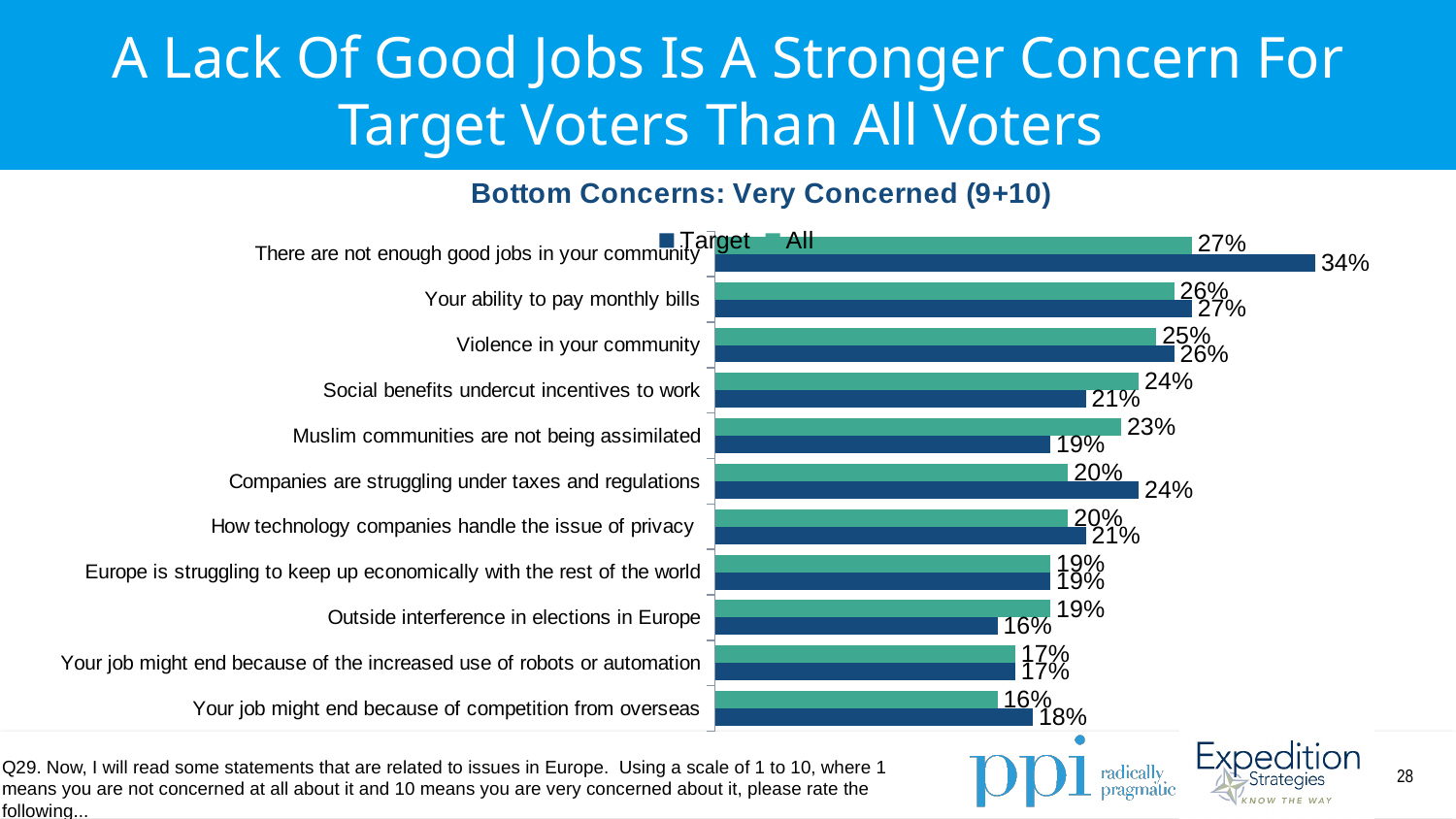
What is the All value for "Social benefits undercut incentives to work"? 24% What is the Target value for "Muslim communities are not being assimilated"? 19% For "Companies are struggling under taxes and regulations", which is larger, the Target value or the All value? Target What is the Target value for "There are not enough good jobs in your community"? 34% How many series does the legend list? 2 What is the title of the chart? Bottom Concerns: Very Concerned (9+10) Which statement has the highest Target value? There are not enough good jobs in your community What is the All value for "There are not enough good jobs in your community"? 27% How many concern statements are plotted in the chart? 11 Which statement has the lowest All value? Your job might end because of competition from overseas What type of chart is shown on the slide? bar chart What is the difference between the Target and All values for "There are not enough good jobs in your community"? 7%